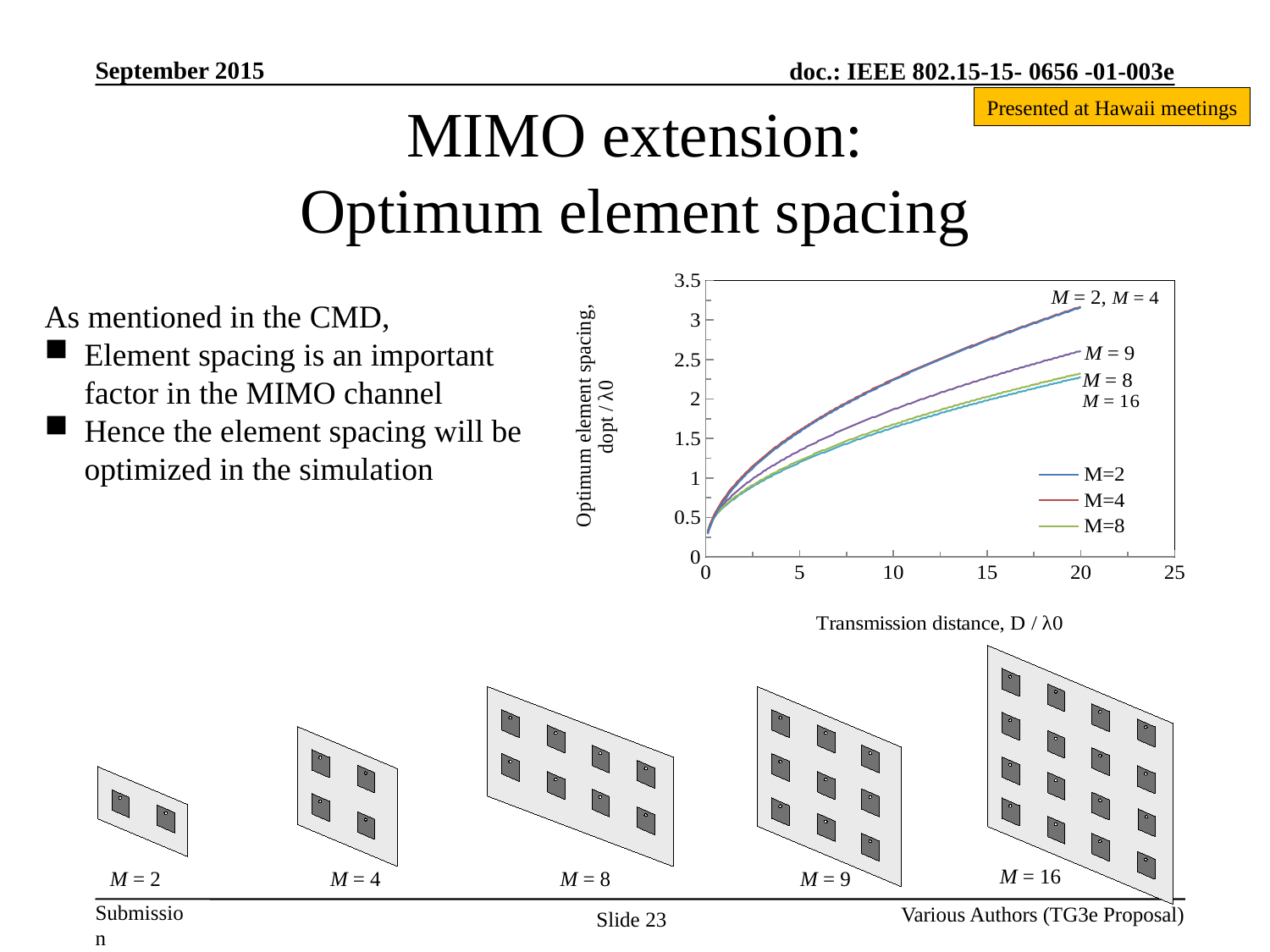
At a transmission distance of 20, which curve has the larger value, M = 9 or M = 8? M = 9 What is the label of the x axis of the chart? Transmission distance, D / λ0 Is the value of the M = 16 curve at a transmission distance of 10 greater or less than 2? less Is the value of the M = 4 curve at a transmission distance of 5 greater or less than 1.5? greater What kind of chart is shown on the slide? line chart Is the value of the M = 8 curve at a transmission distance of 20 greater or less than 2.5? less Do the curves rise or fall as the transmission distance increases? rise At a transmission distance of 20, which curve has the larger value, M = 2 or M = 9? M = 2 Which series are listed in the chart legend? M=2, M=4, M=8 How many series does the chart legend list? 3